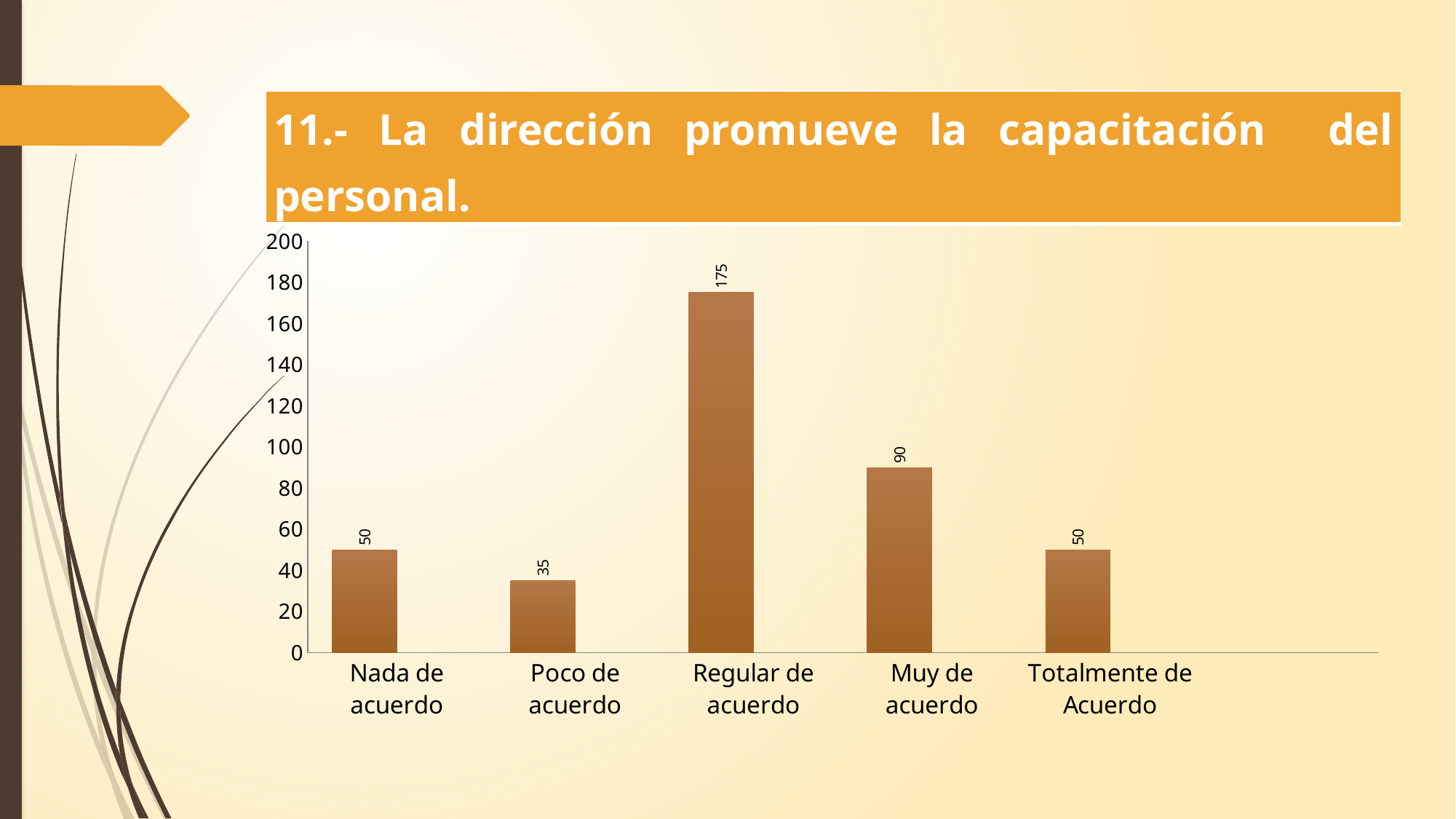
How many categories are shown on the x axis? 5 What is the value for "Nada de acuerdo"? 50 What kind of chart is shown on the slide? Bar chart Is the value for "Regular de acuerdo" greater or less than 160? greater Which category has the highest value? Regular de acuerdo What is the difference between the values for "Regular de acuerdo" and "Muy de acuerdo"? 85 What is the value for "Muy de acuerdo"? 90 What is the title of the slide above the chart? 11.- La dirección promueve la capacitación del personal. Which category has the lowest value? Poco de acuerdo Which is larger, the value for "Muy de acuerdo" or the value for "Totalmente de Acuerdo"? Muy de acuerdo What is the value for "Regular de acuerdo"? 175 What is the value for "Poco de acuerdo"? 35